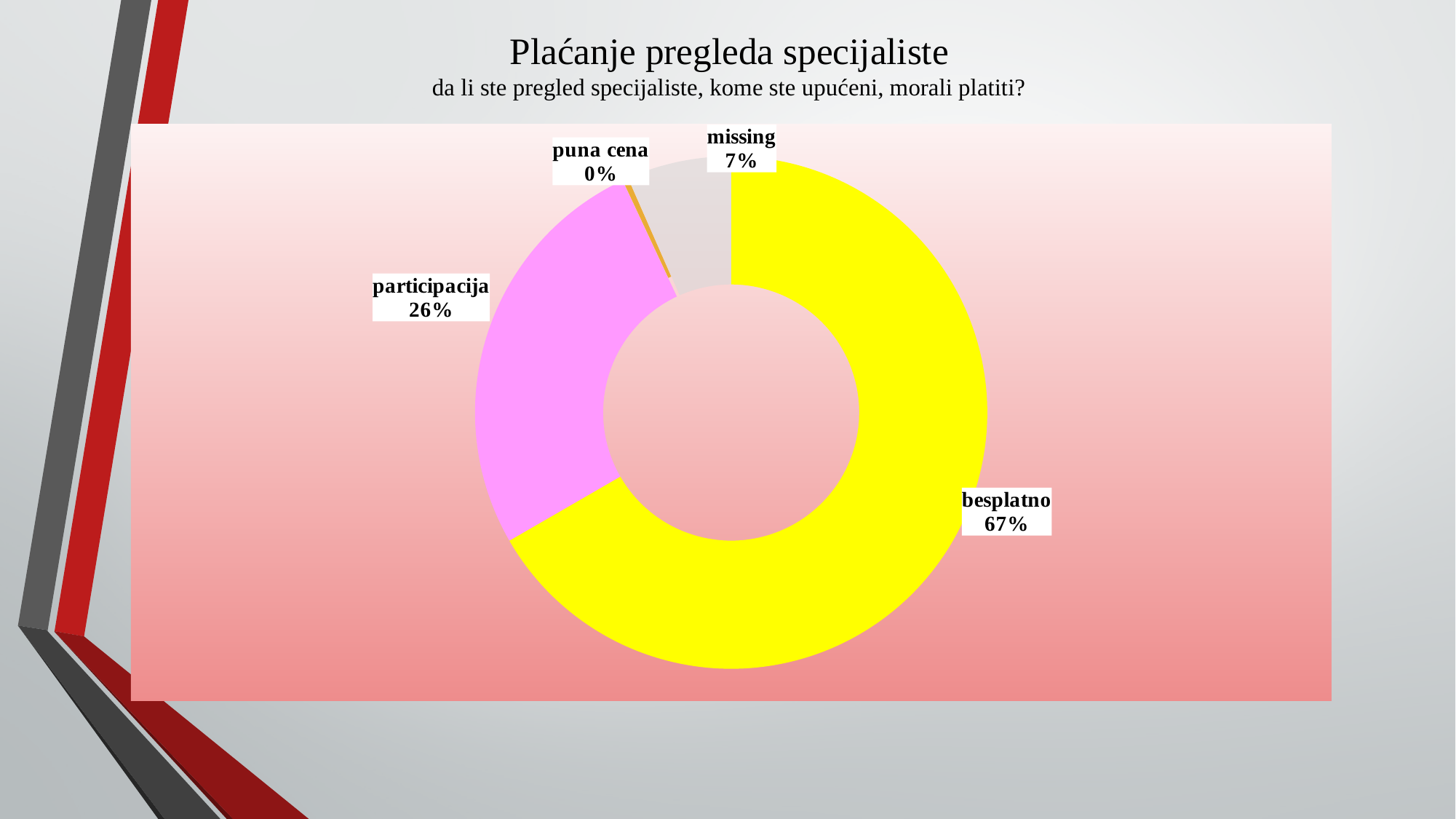
What colour is the 'participacija' slice? Pink Which category has the largest share of the chart? besplatno Which is larger, the share for 'participacija' or the share for 'missing'? participacija What share of the chart does the 'participacija' slice represent? 26% What kind of chart is shown on the slide? Doughnut (pie) chart What percentage is shown for the 'puna cena' slice? 0% What is the difference in percentage points between 'besplatno' and 'participacija'? 41 What share of the chart does the 'besplatno' slice represent? 67% What is the title of the chart? Plaćanje pregleda specijaliste How many categories are shown in the chart? 4 Which category has the smallest share of the chart? puna cena What percentage is shown for the 'missing' slice? 7%